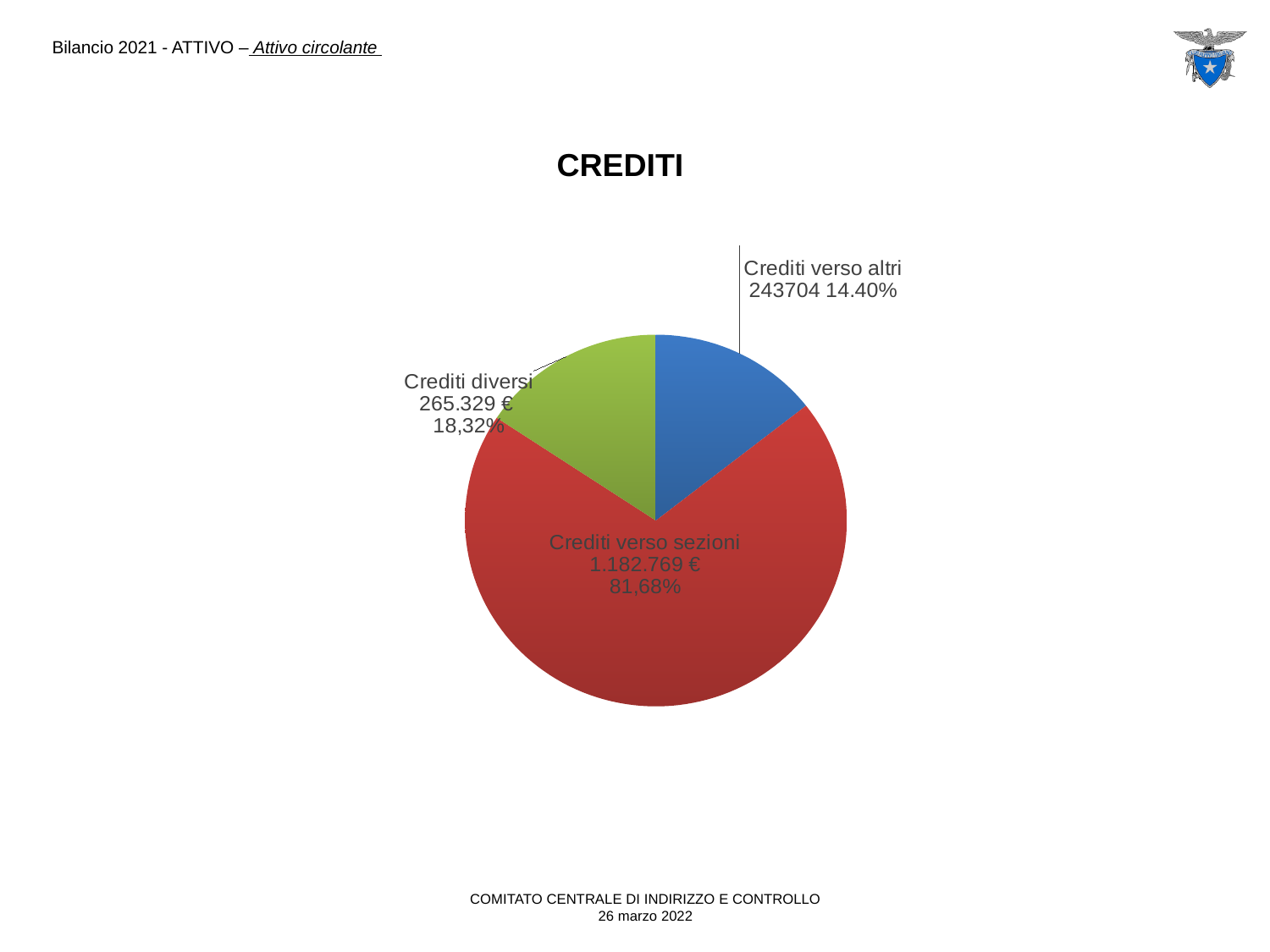
Which category has the largest slice of the pie? Crediti verso sezioni What is the value shown for Crediti verso sezioni? 1.182.769 € What percentage share is shown for Crediti verso sezioni? 81,68% How many slices does the pie chart have? 3 What kind of chart is shown on the slide? pie chart What is the value shown for Crediti diversi? 265.329 € What percentage share is shown for Crediti diversi? 18,32% What is the title of the chart? CREDITI What percentage share is shown for Crediti verso altri? 14.40% What is the value shown for Crediti verso altri? 243704 What is the difference between the values for Crediti verso sezioni and Crediti diversi? 917.440 € Which category has the smallest slice of the pie? Crediti verso altri